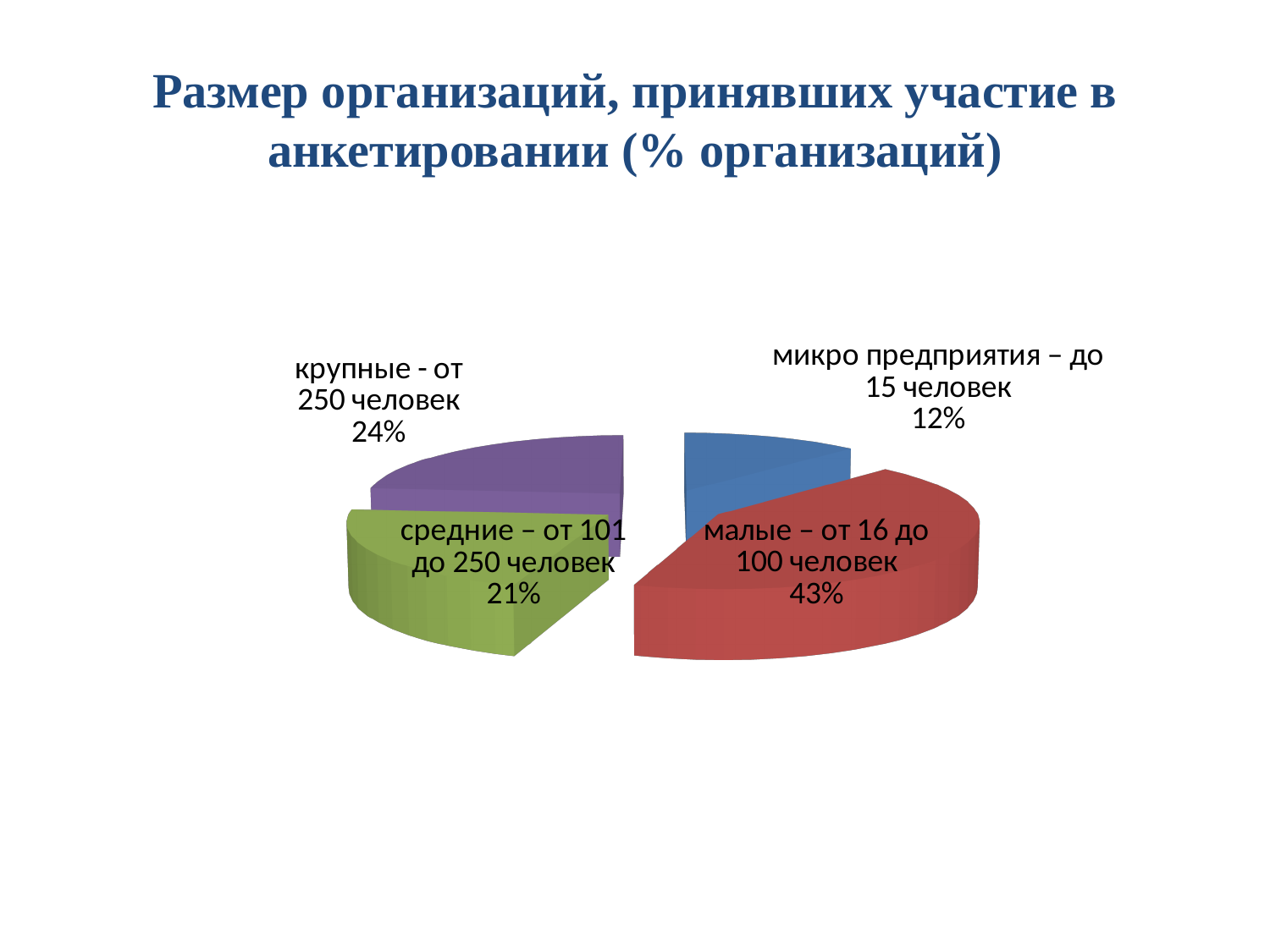
What kind of chart is shown on the slide? pie chart What share of organisations are medium (101 to 250 people)? 21% How many categories does the pie chart show? 4 What colour is the slice for small organisations (16 to 100 people)? red What is the difference in percentage points between the large (over 250 people) and medium (101–250 people) categories? 3 What is the difference in percentage points between the small (16–100 people) and large (over 250 people) categories? 19 Which organisation size category has the largest share? малые – от 16 до 100 человек Which organisation size category has the smallest share? микро предприятия – до 15 человек Which has a larger share: medium organisations (101–250 people) or micro enterprises (up to 15 people)? средние – от 101 до 250 человек What share of organisations are micro enterprises (up to 15 people)? 12% What share of organisations are small (16 to 100 people)? 43% What share of organisations are large (over 250 people)? 24%